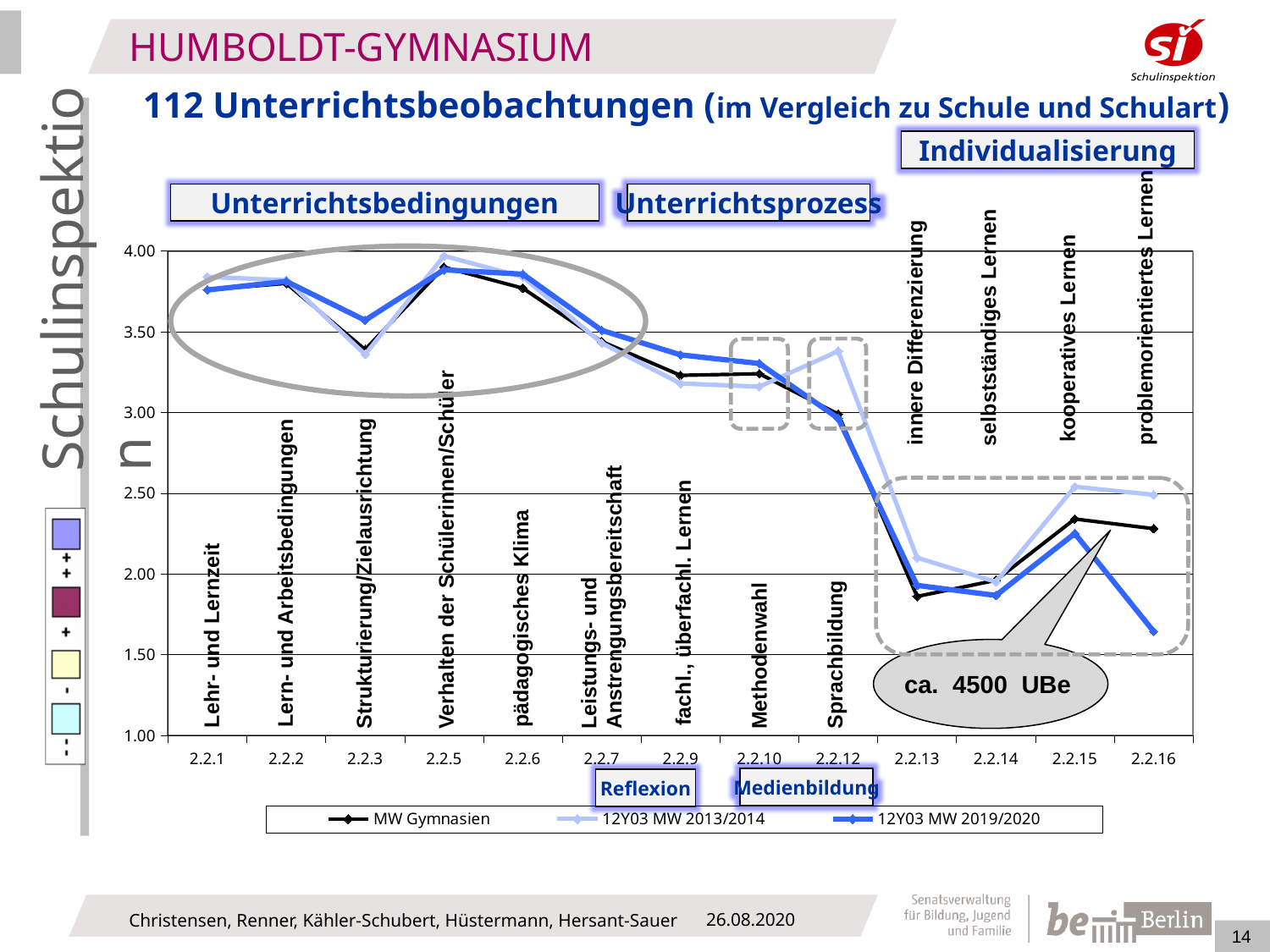
Is the value for 2.2.13 in the 12Y03 MW 2013/2014 series greater or less than 2.50? less How many series does the legend list? 3 Do the values of the 12Y03 MW 2019/2020 series generally rise or fall from 2.2.1 to 2.2.16? fall At 2.2.16, which series has the larger value: 12Y03 MW 2013/2014 or 12Y03 MW 2019/2020? 12Y03 MW 2013/2014 Which series is drawn in black in the chart? MW Gymnasien Is the value for 2.2.1 in the 12Y03 MW 2019/2020 series greater or less than 3.50? greater Is the value for 2.2.5 in the 12Y03 MW 2013/2014 series greater or less than 3.50? greater What kind of chart is shown on the slide? line chart At which category does the 12Y03 MW 2019/2020 series reach its highest value? 2.2.5 At which category does the 12Y03 MW 2019/2020 series reach its lowest value? 2.2.16 How many categories are shown on the x axis? 13